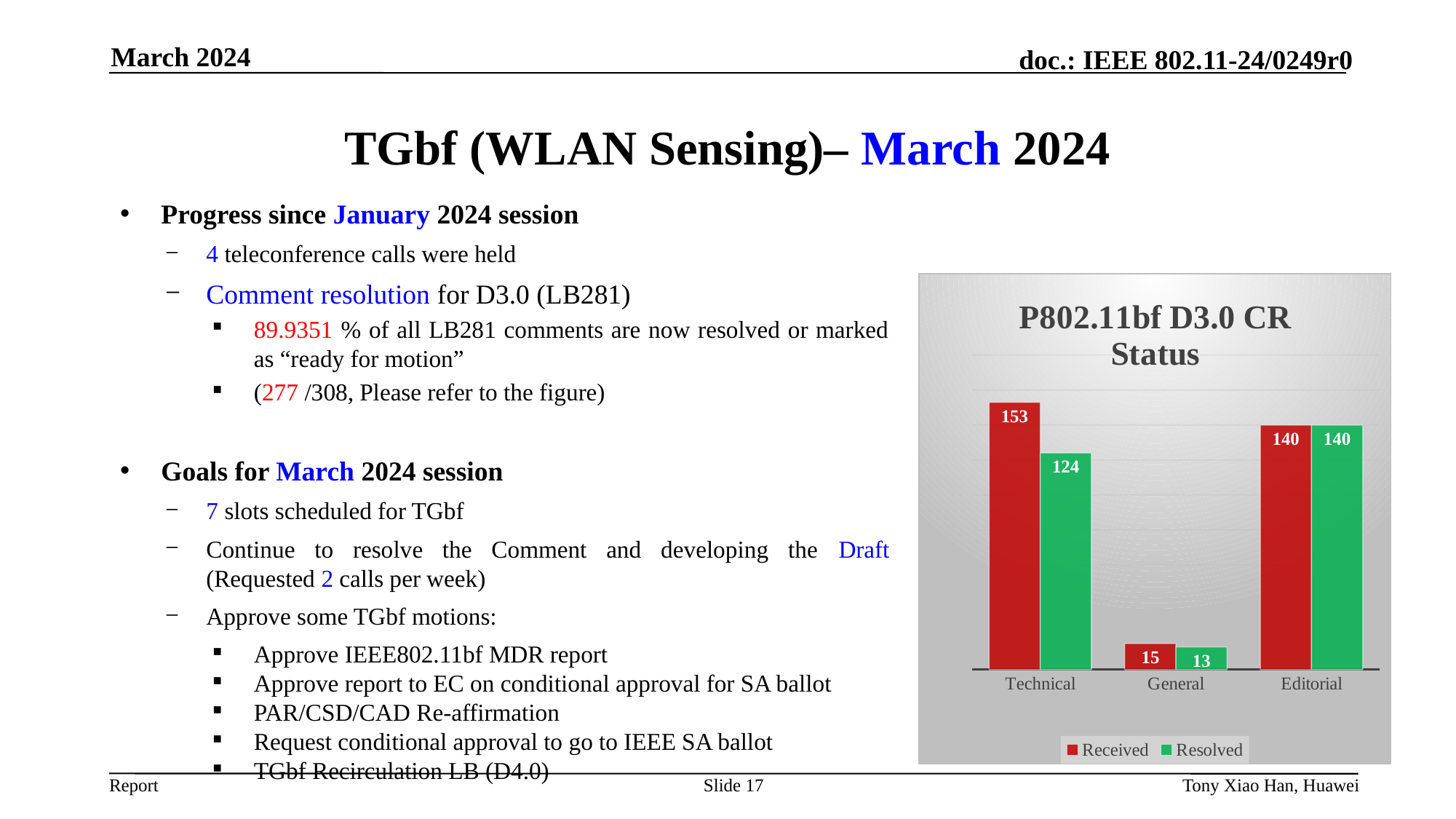
Which category has the lowest Resolved value? General What is the Received value for General? 15 Which category has the highest Received value? Technical How many categories are shown on the x axis of the chart? 3 What is the Received value for Technical? 153 Is the Received value for General larger or smaller than the Resolved value for General? larger What is the difference between Received and Resolved for Technical? 29 What is the Resolved value for Technical? 124 What is the title of the chart? P802.11bf D3.0 CR Status What is the Resolved value for Editorial? 140 How many series does the chart legend list? 2 What type of chart is shown on the slide? bar chart